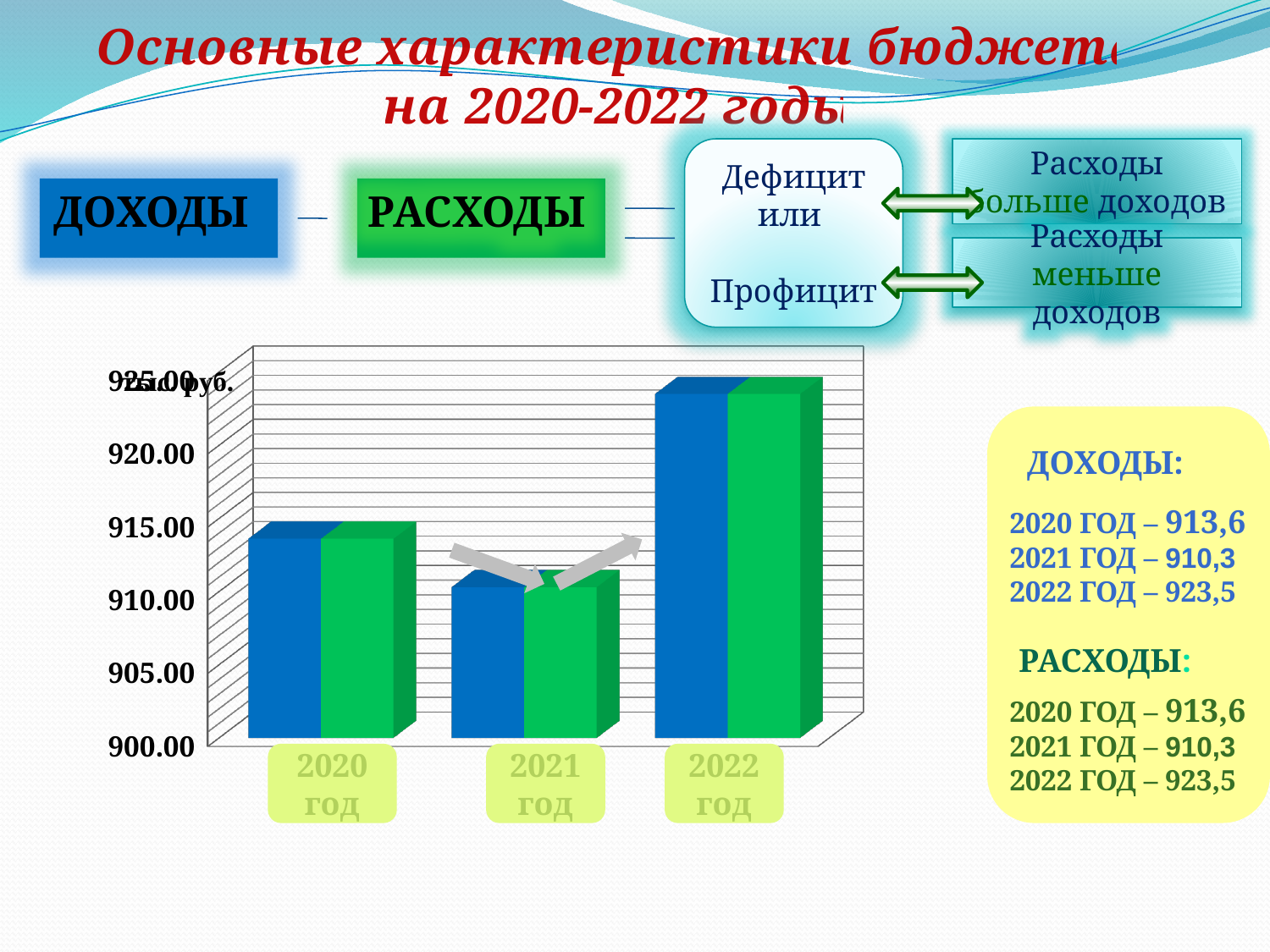
According to the slide, what is the ДОХОДЫ value for 2022 год? 923,5 What colour are the ДОХОДЫ bars in the chart? blue How many year categories are shown on the x axis of the chart? 3 According to the values printed on the slide, what is the difference between the 2022 год and 2021 год values? 13,2 Which year has the shortest bars in the chart? 2021 год Is the value for 2020 год greater or less than 915.00? less Do the bar values fall or rise from 2020 год to 2021 год? fall Is the value for 2022 год greater or less than 920.00? greater Which year has the tallest bars in the chart? 2022 год Is the value for 2021 год greater or less than 915.00? less What kind of chart is shown on the slide? bar chart Which is larger, the value for 2020 год or the value for 2021 год? 2020 год